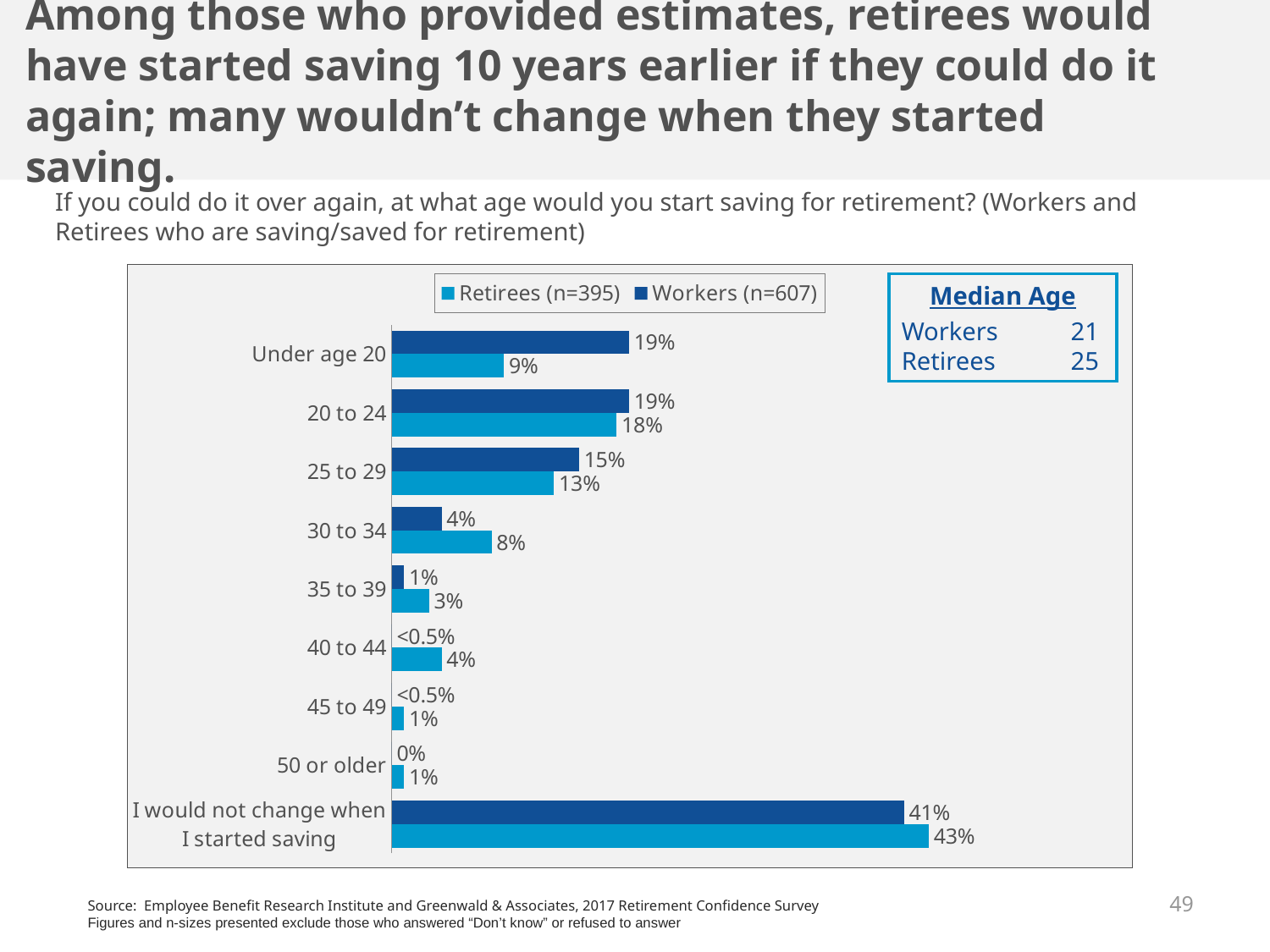
According to the Median Age box, what is the median age for Retirees? 25 What percentage of Workers would start saving under age 20 if they could do it over again? 19% What percentage of Retirees said they would not change when they started saving? 43% What is the Retirees value for the 30 to 34 age group? 8% What type of chart is shown on the slide? Bar chart What is the difference between the Workers and Retirees values for Under age 20? 10 percentage points Which category has the highest value for Workers? I would not change when I started saving How many categories are shown on the chart? 9 How many series does the legend list? 2 For the 30 to 34 age group, which series has the larger value, Workers or Retirees? Retirees What is the Workers value for the 50 or older category? 0%